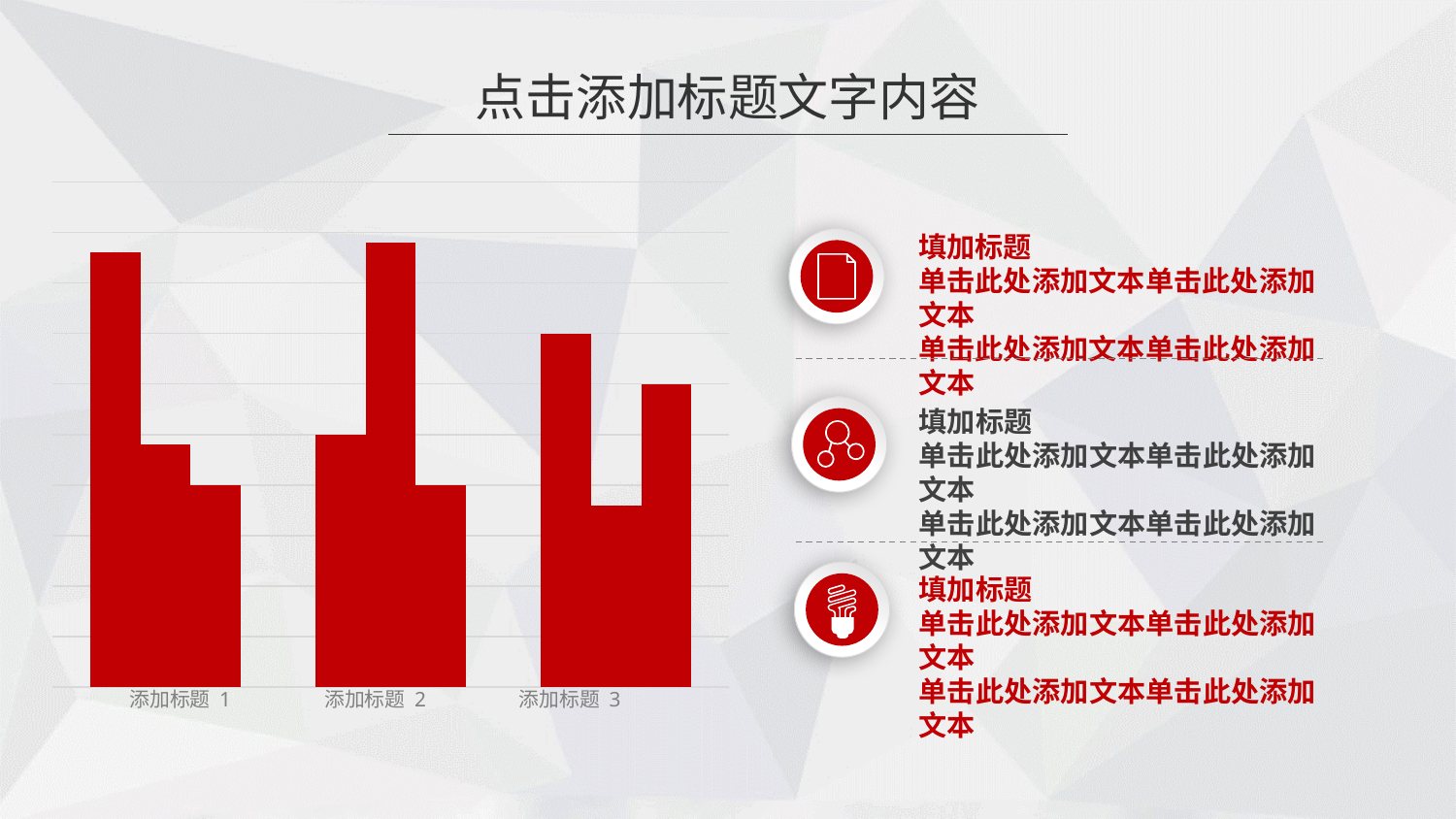
Which is taller: the first bar of 添加标题 1 or the first bar of 添加标题 2? the first bar of 添加标题 1 Within the category 添加标题 2, which bar is the tallest: the first, second or third? the second Which is taller: the third bar of 添加标题 3 or the third bar of 添加标题 1? the third bar of 添加标题 3 Which is taller: the second bar of 添加标题 2 or the second bar of 添加标题 3? the second bar of 添加标题 2 Within the category 添加标题 1, which bar is the shortest: the first, second or third? the third Within the category 添加标题 3, which bar is the shortest: the first, second or third? the second How many categories are shown on the x axis of the chart? 3 Within the category 添加标题 1, which bar is the tallest: the first, second or third? the first What kind of chart is shown on the slide? bar chart How many bars are plotted for each category in the chart? 3 What is the label of the first category on the x axis? 添加标题 1 What colour are the bars in the chart? red